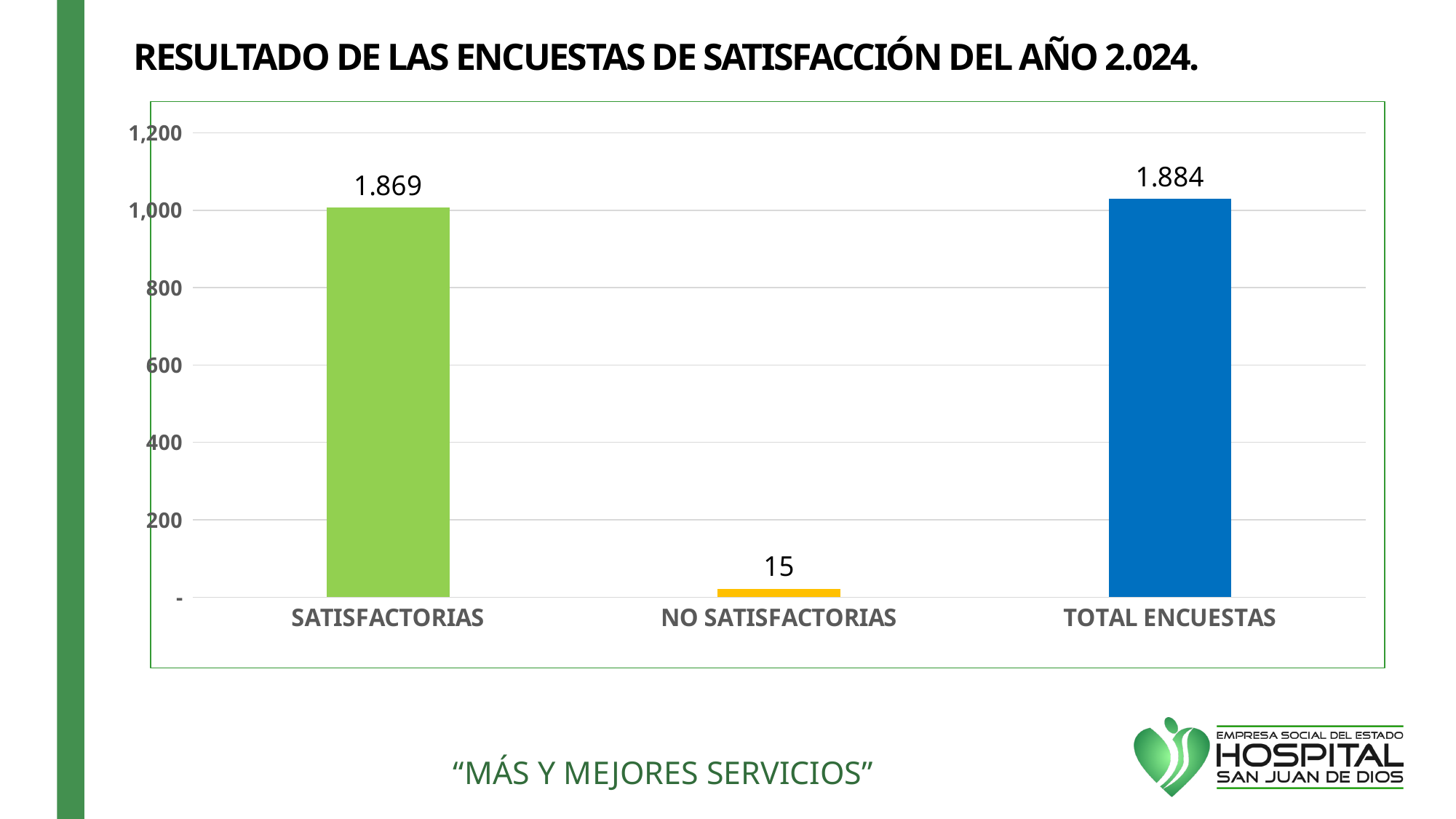
How many categories are shown on the x axis? 3 What is the value shown for SATISFACTORIAS? 1.869 What is the title of the slide above the chart? RESULTADO DE LAS ENCUESTAS DE SATISFACCIÓN DEL AÑO 2.024. Which category has the lowest value? NO SATISFACTORIAS Which category has the highest value? TOTAL ENCUESTAS Is the value for NO SATISFACTORIAS greater or less than 200? less Which is larger, the value for SATISFACTORIAS or the value for NO SATISFACTORIAS? SATISFACTORIAS What colour is the bar for TOTAL ENCUESTAS? blue Is the bar for SATISFACTORIAS above or below the 800 gridline? above What is the value shown for TOTAL ENCUESTAS? 1.884 What kind of chart is shown on the slide? bar chart What is the value shown for NO SATISFACTORIAS? 15